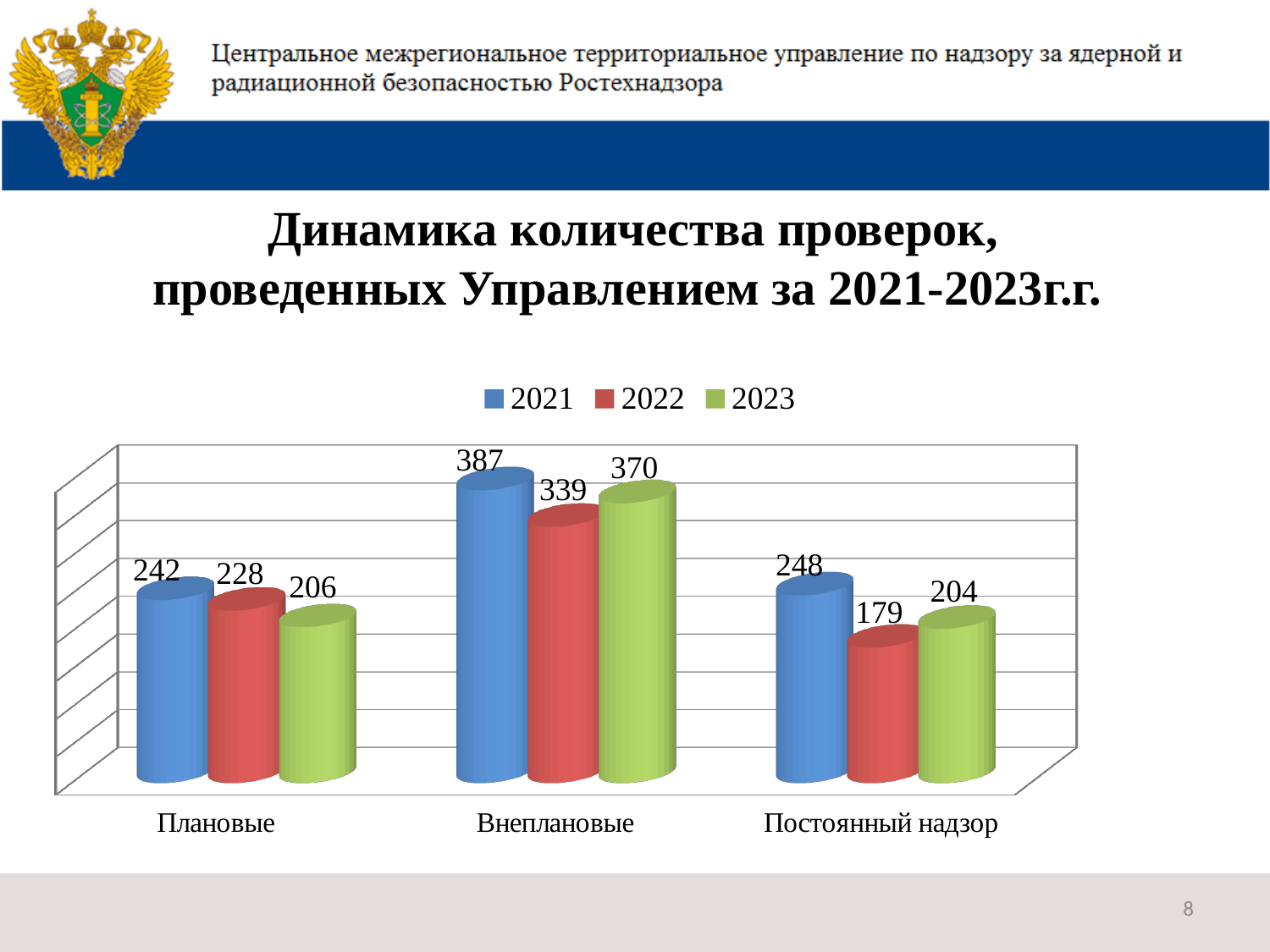
What kind of chart is shown on the slide? Bar chart What is the value for Внеплановые in 2022? 339 How many categories are shown on the x axis? 3 What is the difference between the 2021 and 2022 values for Постоянный надзор? 69 How many series does the legend list? 3 What is the value for Плановые in 2021? 242 What is the value for Постоянный надзор in 2023? 204 Do the values for Плановые rise or fall from 2021 to 2023? Fall What is the difference between the 2021 and 2023 values for Внеплановые? 17 Which is larger: the 2022 value for Плановые or the 2023 value for Плановые? 2022 value for Плановые Which category has the highest value in 2021? Внеплановые Which category has the lowest value in 2022? Постоянный надзор